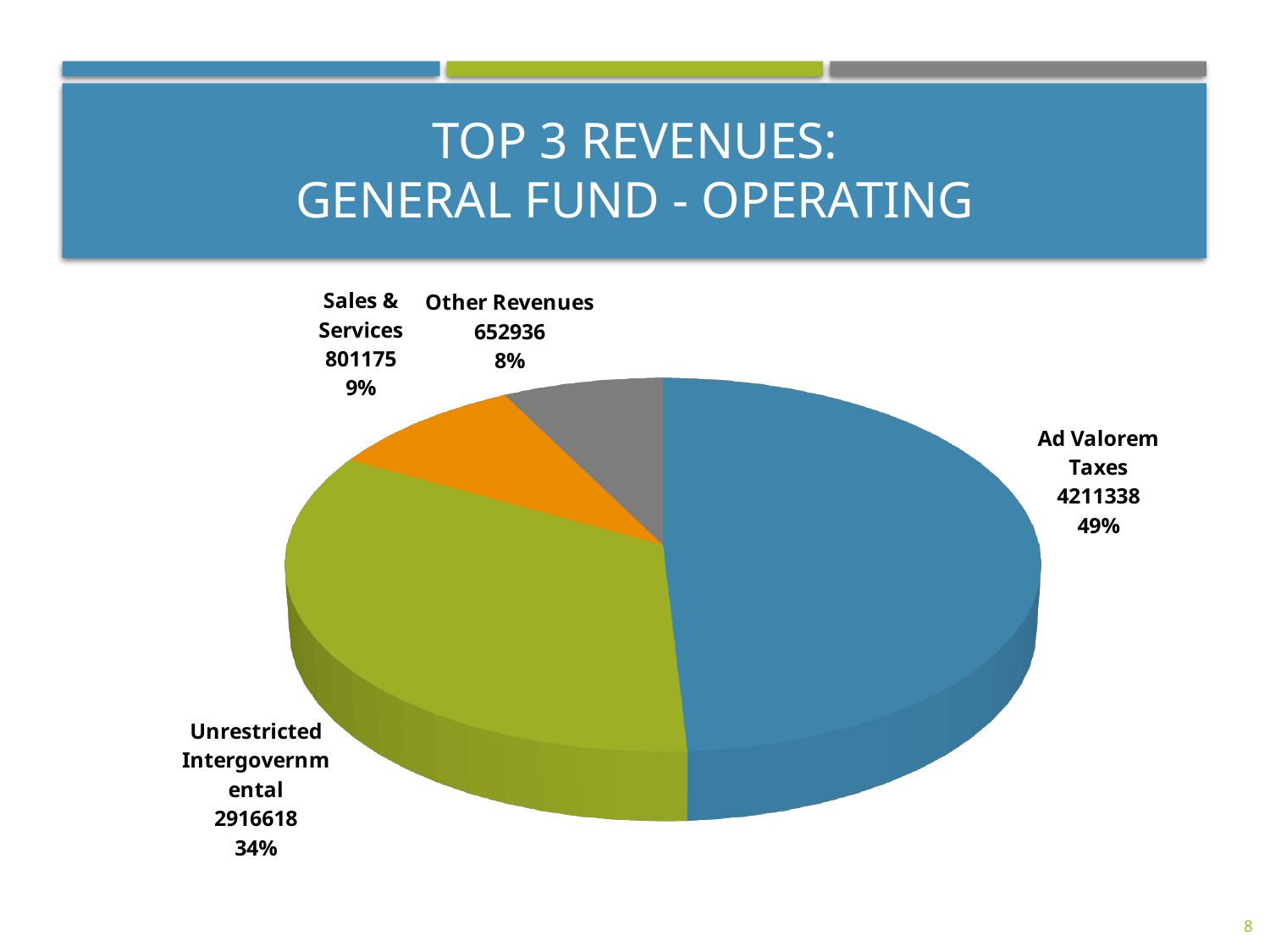
What share of the pie does Unrestricted Intergovernmental represent? 34% What is the value for Unrestricted Intergovernmental? 2916618 Which is larger, Sales & Services or Other Revenues? Sales & Services Which category has the largest slice? Ad Valorem Taxes What type of chart is shown on the slide? Pie chart How many categories are shown in the pie chart? 4 What share of the pie does Other Revenues represent? 8% Which category has the smallest slice? Other Revenues What is the difference between the values for Ad Valorem Taxes and Unrestricted Intergovernmental? 1294720 What is the value for Other Revenues? 652936 What is the value for Ad Valorem Taxes? 4211338 What is the value for Sales & Services? 801175